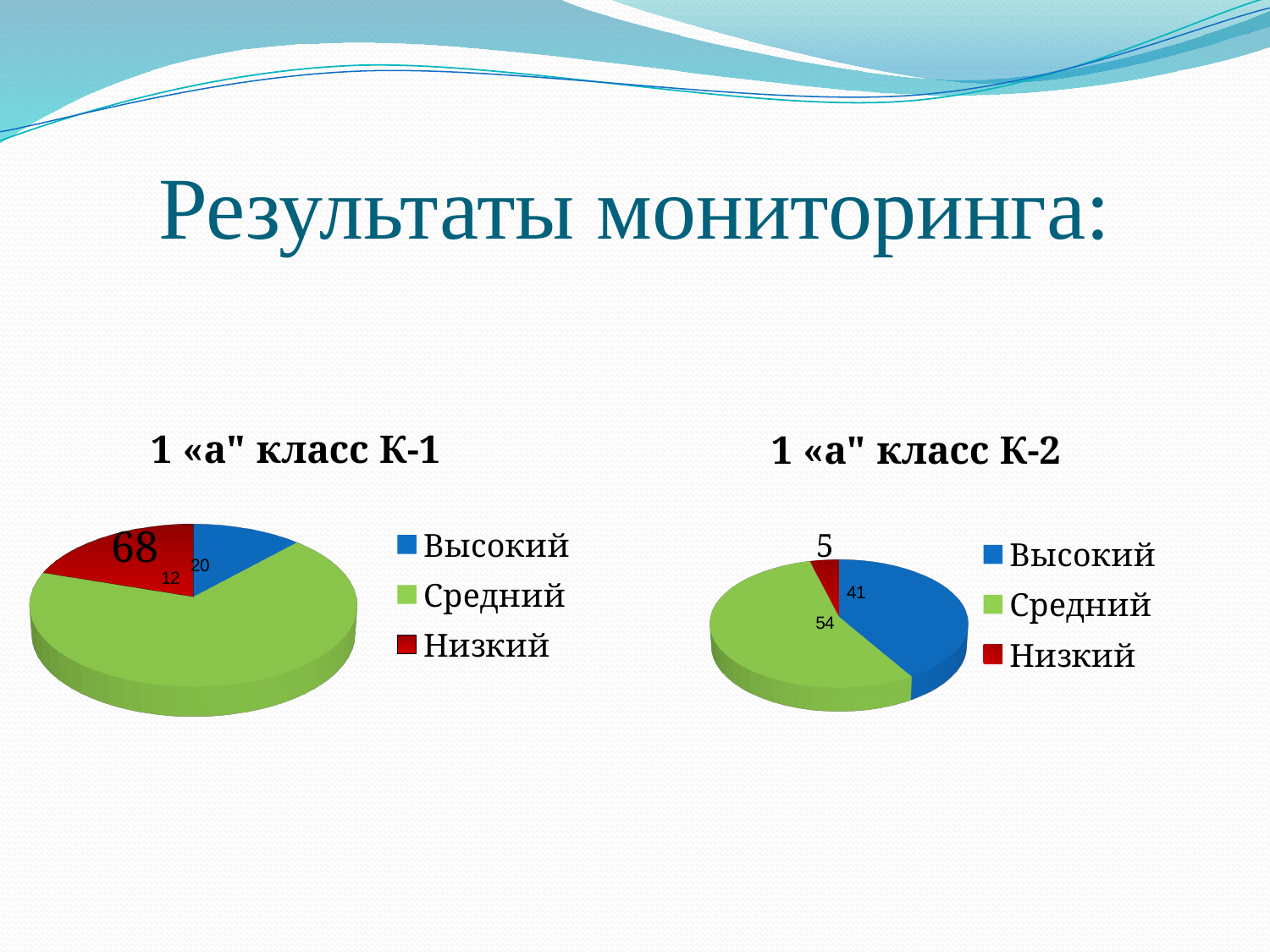
What kind of chart is used for 1 «а" класс К-1? pie chart In the 1 «а" класс К-2 chart, what is the difference between Средний and Высокий? 13 In the 1 «а" класс К-2 chart, which category has the smallest slice? Низкий In the 1 «а" класс К-1 chart, which category has the largest slice? Средний In the 1 «а" класс К-2 chart, what is the value for Средний? 54 How many categories does the legend of the 1 «а" класс К-2 chart list? 3 Which is larger: Высокий in the 1 «а" класс К-1 chart or Высокий in the 1 «а" класс К-2 chart? 1 «а" класс К-2 In the 1 «а" класс К-1 chart, which category has the smallest slice? Высокий In the 1 «а" класс К-2 chart, what is the value for Низкий? 5 In the 1 «а" класс К-2 chart, what is the value for Высокий? 41